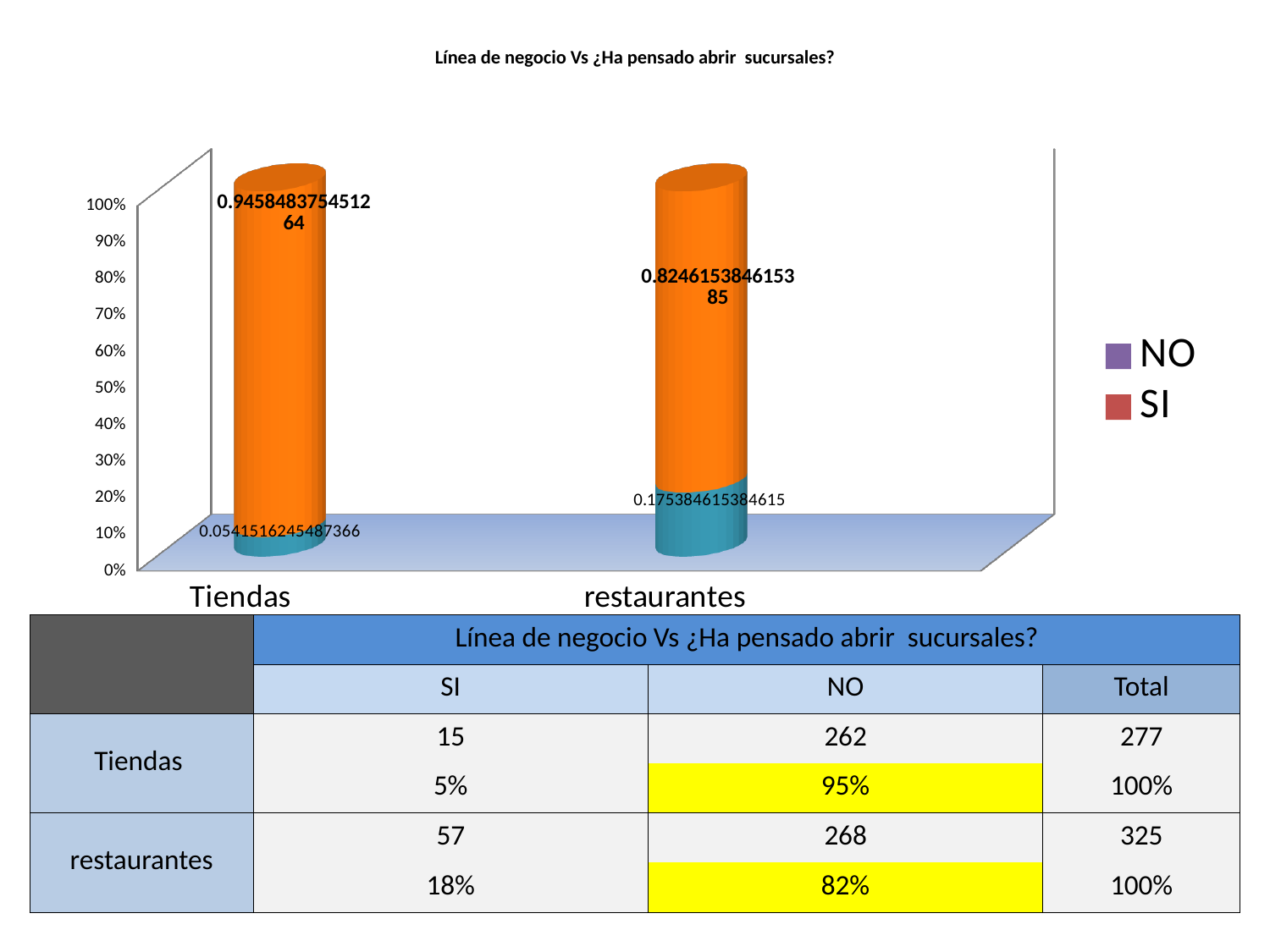
What is the data label on the large upper (orange) segment of the restaurantes bar? 0.824615384615385 What is the data label on the small lower (teal) segment of the Tiendas bar? 0.0541516245487366 How many series does the chart legend list? 2 What is the data label on the large upper (orange) segment of the Tiendas bar? 0.945848375451264 Which entries appear in the chart legend? NO and SI Which category has the larger upper (orange) segment, Tiendas or restaurantes? Tiendas Which category has the larger lower (teal) segment, Tiendas or restaurantes? restaurantes Is the value of the lower (teal) segment for Tiendas greater or less than 10%? less What is the data label on the lower (teal) segment of the restaurantes bar? 0.175384615384615 What is the title of the chart? Línea de negocio Vs ¿Ha pensado abrir sucursales? How many categories are shown on the x axis of the chart? 2 What kind of chart is shown on the slide? bar chart